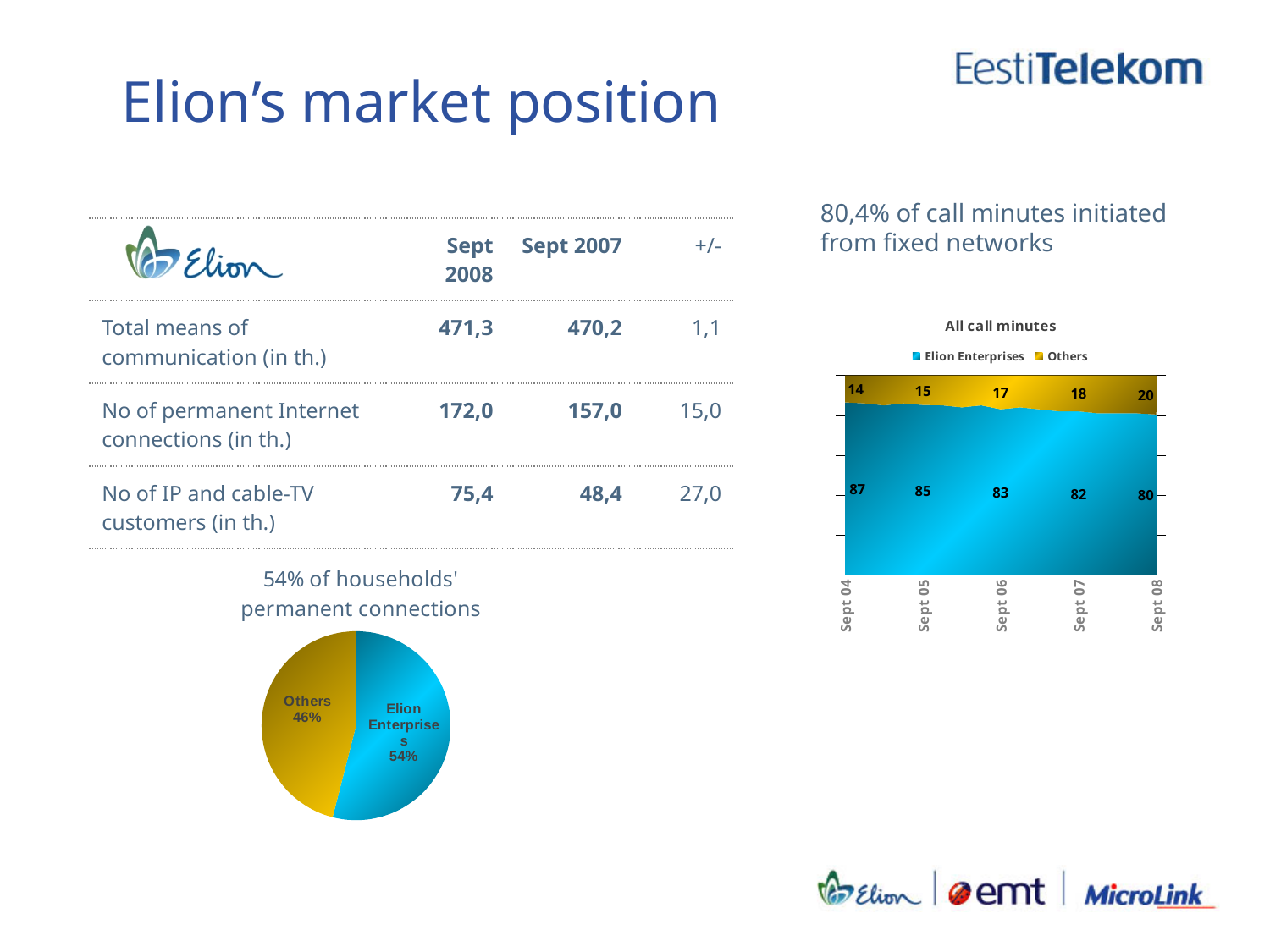
In the 'All call minutes' chart, does the Elion Enterprises value rise or fall from Sept 04 to Sept 08? fall In the 'All call minutes' chart, how many time periods are shown on the x axis? 5 In the 'All call minutes' chart, what is the value for Elion Enterprises in Sept 06? 83 In the 'All call minutes' chart, what is the total of the two series in Sept 07? 100 In the 'All call minutes' chart, what is the value for Others in Sept 08? 20 In the 'All call minutes' chart, what is the difference between the Elion Enterprises values in Sept 04 and Sept 08? 7 In the pie chart titled '54% of households' permanent connections', what share does Others have? 46% In the 'All call minutes' chart, in which period is the Others value highest? Sept 08 In the 'All call minutes' chart, what is the value for Elion Enterprises in Sept 04? 87 In the 'All call minutes' chart, in which period is the Elion Enterprises value lowest? Sept 08 In the 'All call minutes' chart, how many series does the legend list? 2 What kind of chart is the one titled '54% of households' permanent connections'? pie chart